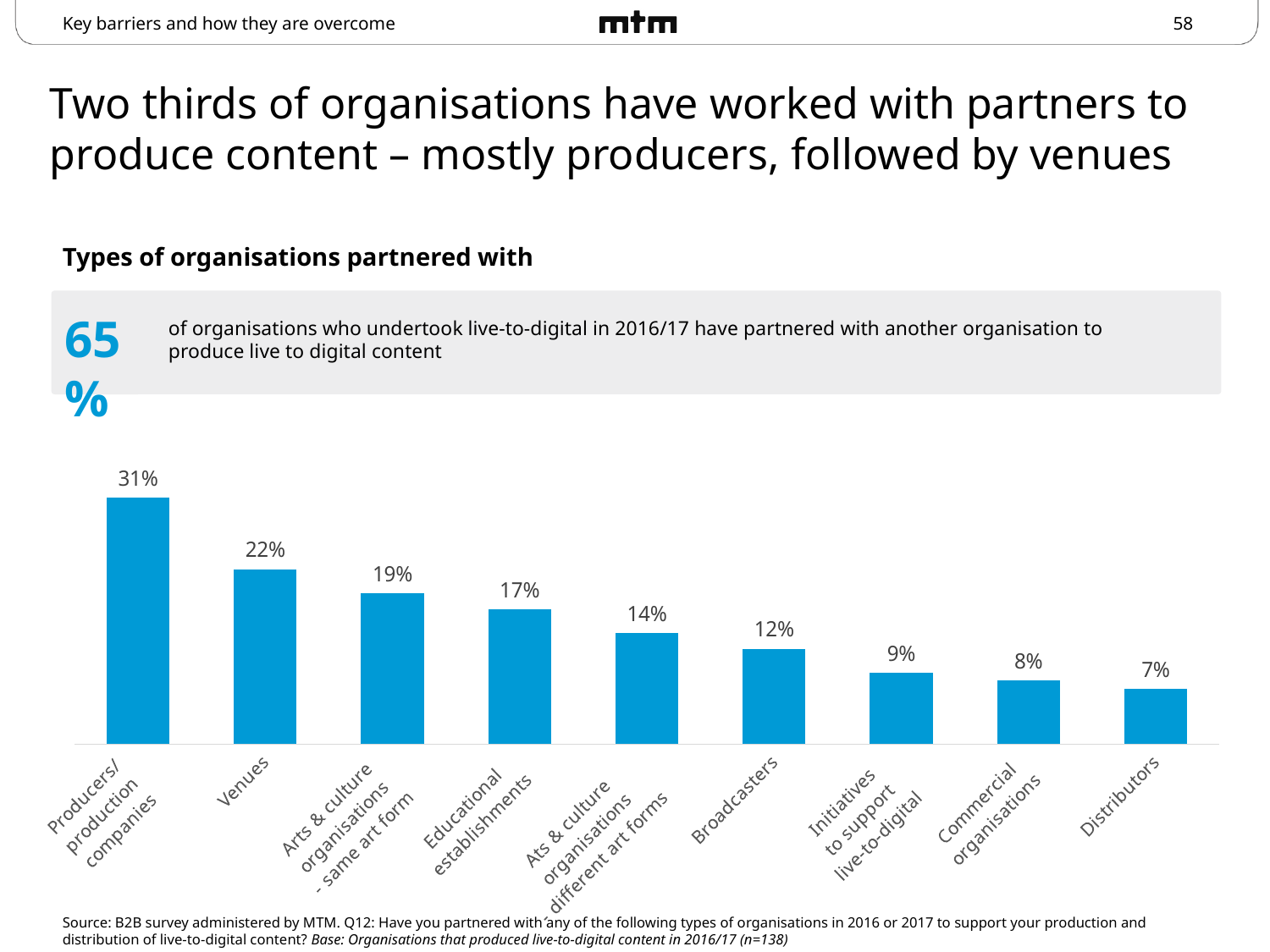
What is the title of the chart? Types of organisations partnered with Do the values rise or fall from left to right across the chart? Fall How many types of organisations are shown in the chart? 9 Which is larger: the value for Educational establishments or the value for Broadcasters? Educational establishments Which type of organisation has the lowest percentage in the chart? Distributors What percentage of organisations partnered with producers/production companies? 31% What percentage is shown for Broadcasters? 12% Which type of organisation has the highest percentage in the chart? Producers/production companies What is the value for Distributors? 7% What is the difference in percentage points between Producers/production companies and Venues? 9 What kind of chart is shown on the slide? Bar chart What is the value shown for Venues? 22%